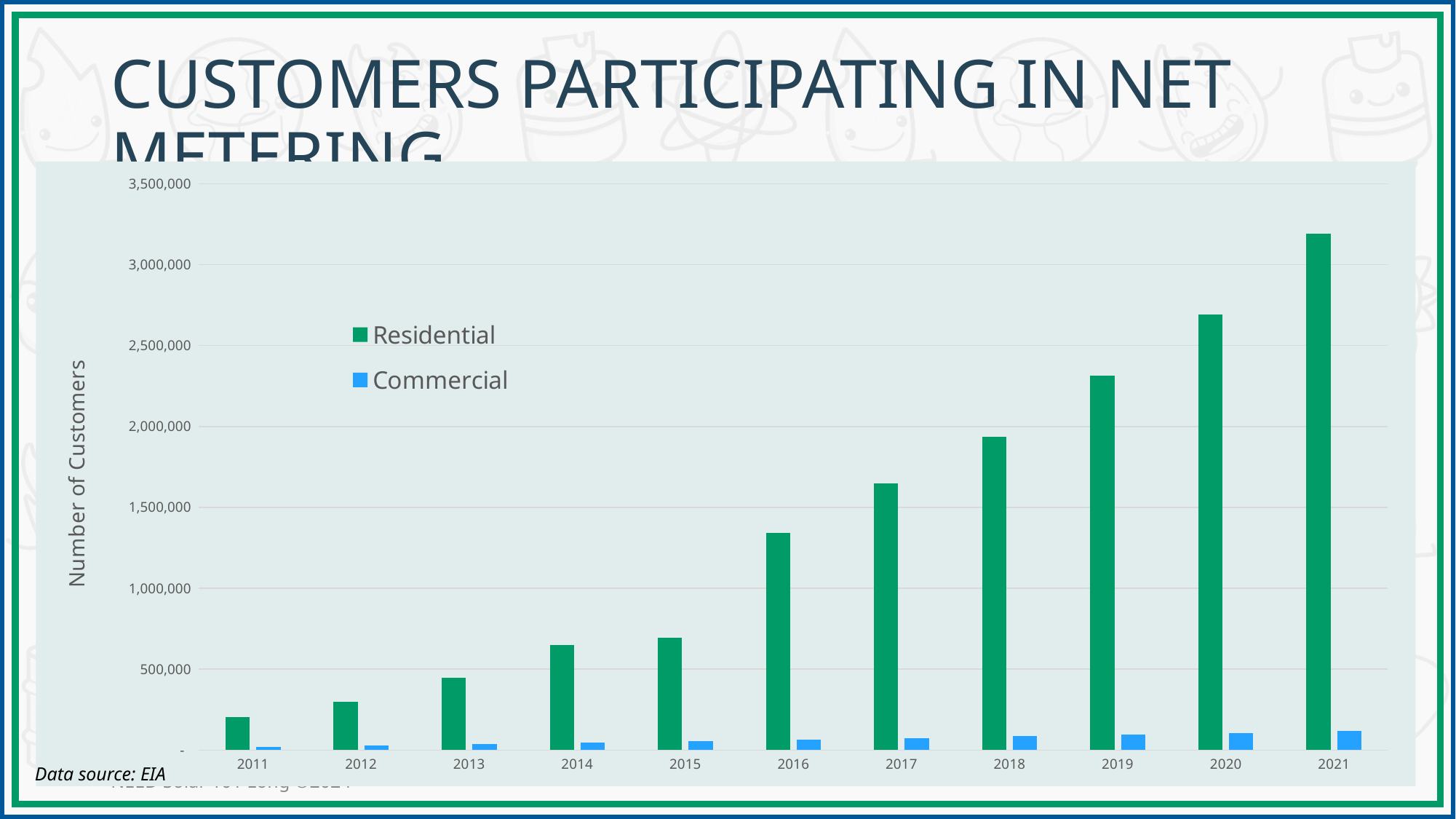
How many series does the legend list? 2 In which year is the Residential value highest? 2021 In 2021, which series has the larger value, Residential or Commercial? Residential In which year is the Residential value lowest? 2011 What is the label on the vertical axis? Number of Customers Is the Residential value for 2011 greater or less than 500,000? less How many years are shown on the x axis? 11 Is the Residential value for 2021 greater or less than 3,000,000? greater What kind of chart is shown on the slide? bar chart Do the Residential values rise or fall from 2011 to 2021? rise Is the Residential value for 2016 greater or less than 1,000,000? greater